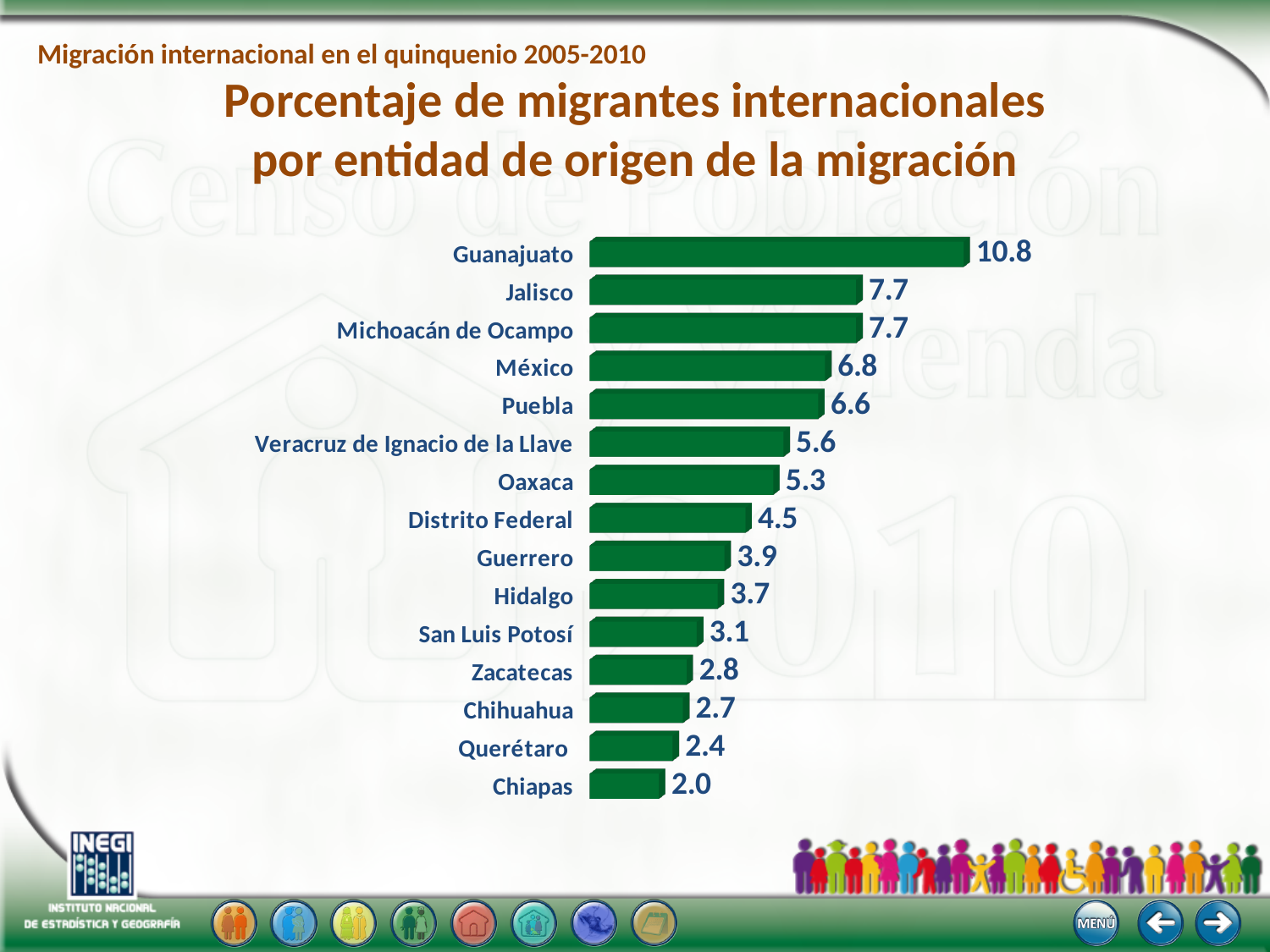
What is the title of the chart? Porcentaje de migrantes internacionales por entidad de origen de la migración What is the difference between the values for Guanajuato and Jalisco? 3.1 Which is larger, the value for Puebla or the value for Guerrero? Puebla What is the value for Veracruz de Ignacio de la Llave? 5.6 Which entity has the lowest percentage of international migrants? Chiapas What is the value for Guanajuato? 10.8 What kind of chart is shown on the slide? Bar chart What is the value for Oaxaca? 5.3 Which two entities share the same value of 7.7? Jalisco and Michoacán de Ocampo How many entities are shown in the chart? 15 What is the difference between the values for Distrito Federal and Chiapas? 2.5 Which entity has the highest percentage of international migrants? Guanajuato